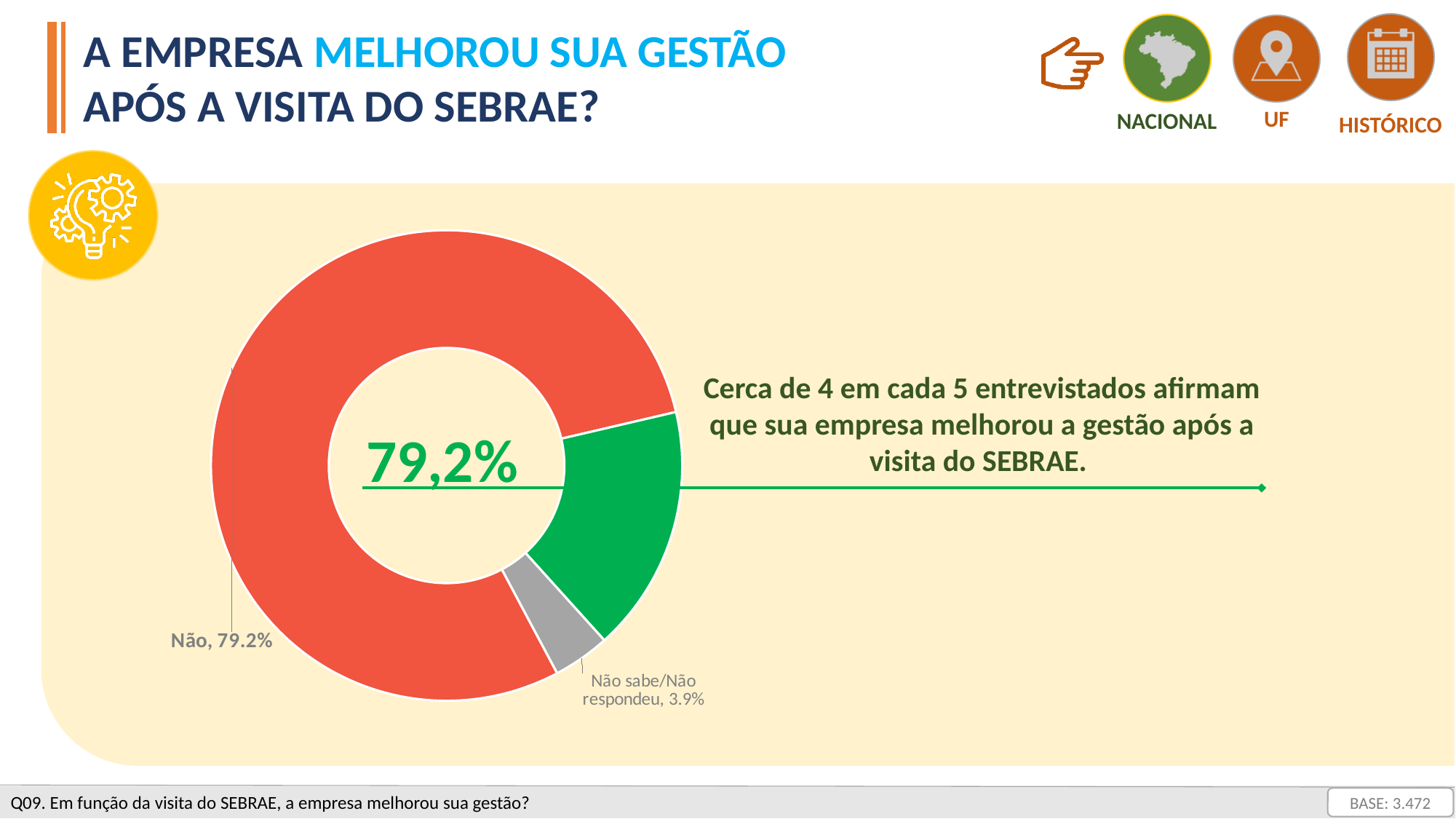
How many slices does the chart have? 3 Which labelled slice of the chart is the largest? Não What share of the pie does the "Não" slice represent? 79.2% Which slice of the chart is the smallest? Não sabe/Não respondeu What percentage is shown for the "Não" slice? 79.2% What is the difference in percentage points between the "Não" slice and the "Não sabe/Não respondeu" slice? 75.3 percentage points Which is larger, the "Não" slice or the "Não sabe/Não respondeu" slice? Não What value is printed in the centre of the donut chart? 79,2% What colour is the "Não sabe/Não respondeu" slice? grey What kind of chart is shown on the slide? pie chart (donut) What percentage is shown for the "Não sabe/Não respondeu" slice? 3.9%